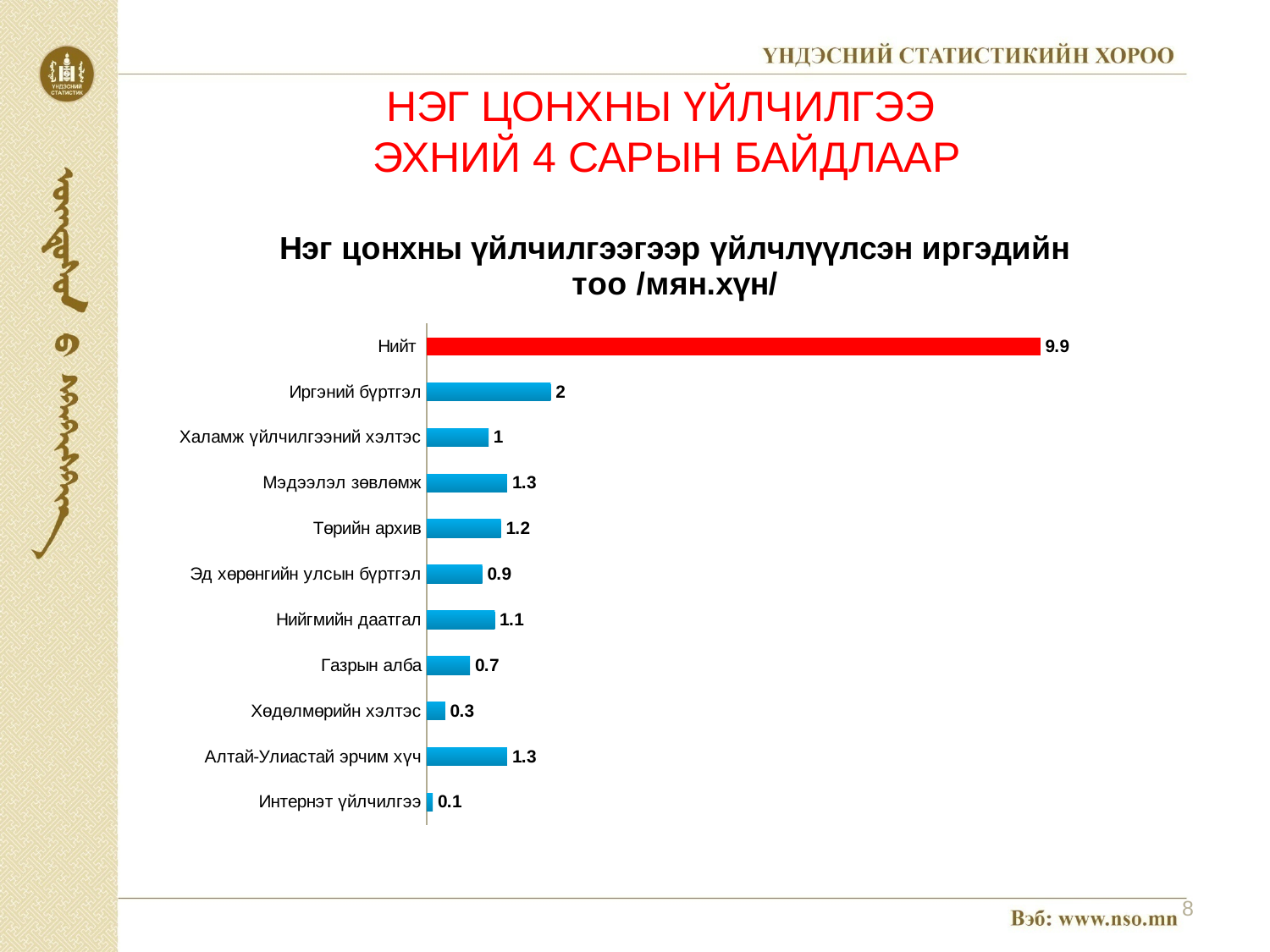
What is the value for Хөдөлмөрийн хэлтэс? 0.3 Which is larger, the value for Нийгмийн даатгал or the value for Газрын алба? Нийгмийн даатгал What is the title of the chart? Нэг цонхны үйлчилгээгээр үйлчлүүлсэн иргэдийн тоо /мян.хүн/ What is the value for Төрийн архив? 1.2 What is the difference between the values for Нийт and Иргэний бүртгэл? 7.9 How many categories are shown in the chart? 11 What is the value for Иргэний бүртгэл? 2 Which category has the highest value? Нийт Which category has the lowest value? Интернэт үйлчилгээ What is the value for Нийт? 9.9 What is the difference between the values for Иргэний бүртгэл and Халамж үйлчилгээний хэлтэс? 1 What kind of chart is shown on the slide? Bar chart